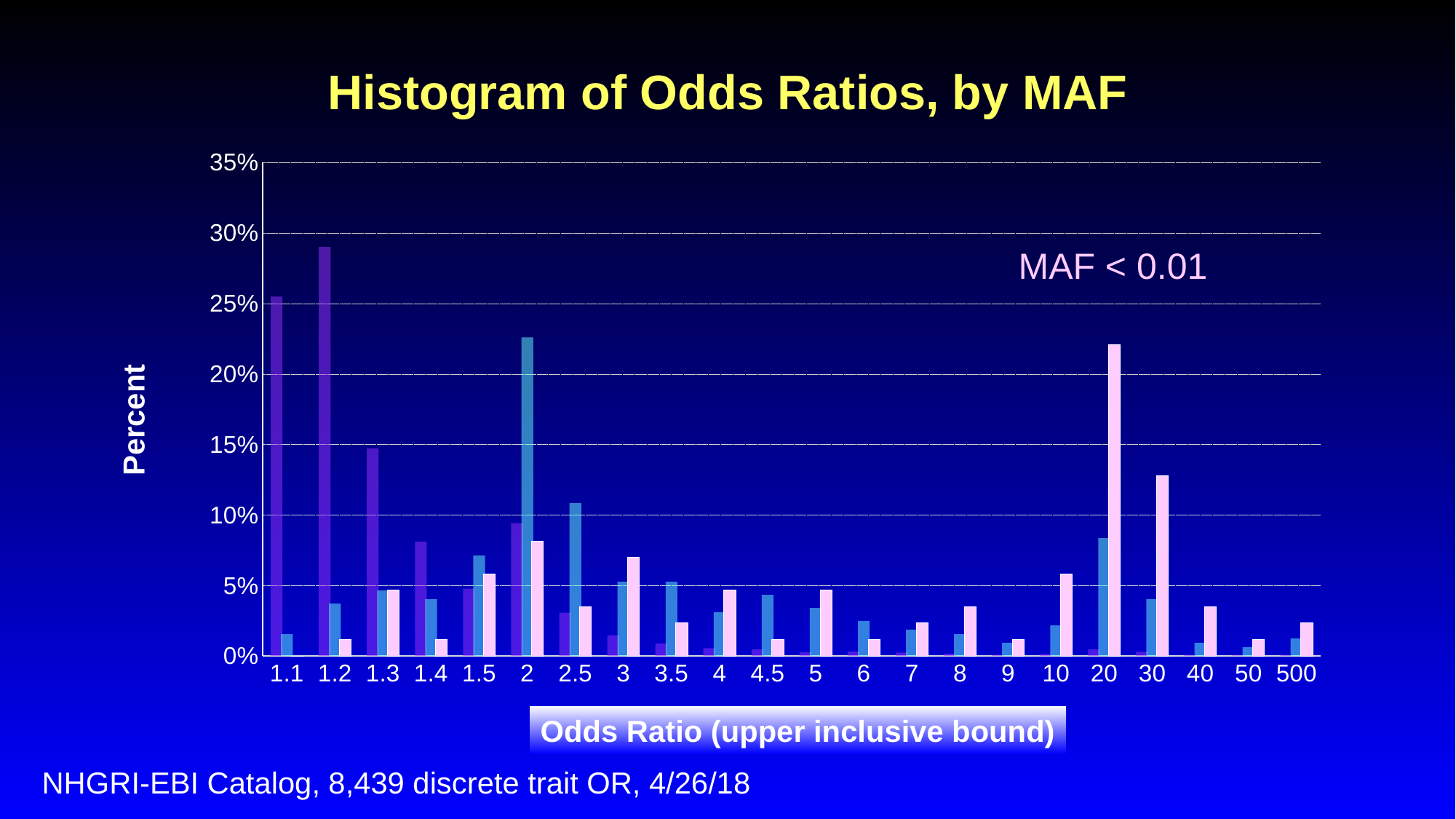
For the blue series, which odds ratio category has the highest bar? 2 Is the purple bar at odds ratio 1.2 greater or less than 25%? greater Which is larger: the pink (MAF < 0.01) bar at odds ratio 20 or the pink bar at odds ratio 30? 20 For the purple series, which odds ratio category has the highest bar? 1.2 For the pink (MAF < 0.01) series, which odds ratio category has the highest bar? 20 What is the title of the chart? Histogram of Odds Ratios, by MAF Do the purple bars generally rise or fall as the odds ratio increases along the x axis? Fall What kind of chart is shown on the slide? Bar chart Is the pink (MAF < 0.01) bar at odds ratio 40 greater or less than 5%? less How many odds ratio categories are shown on the x axis? 22 Is the pink (MAF < 0.01) bar at odds ratio 30 greater or less than 10%? greater What is the label of the x axis? Odds Ratio (upper inclusive bound)